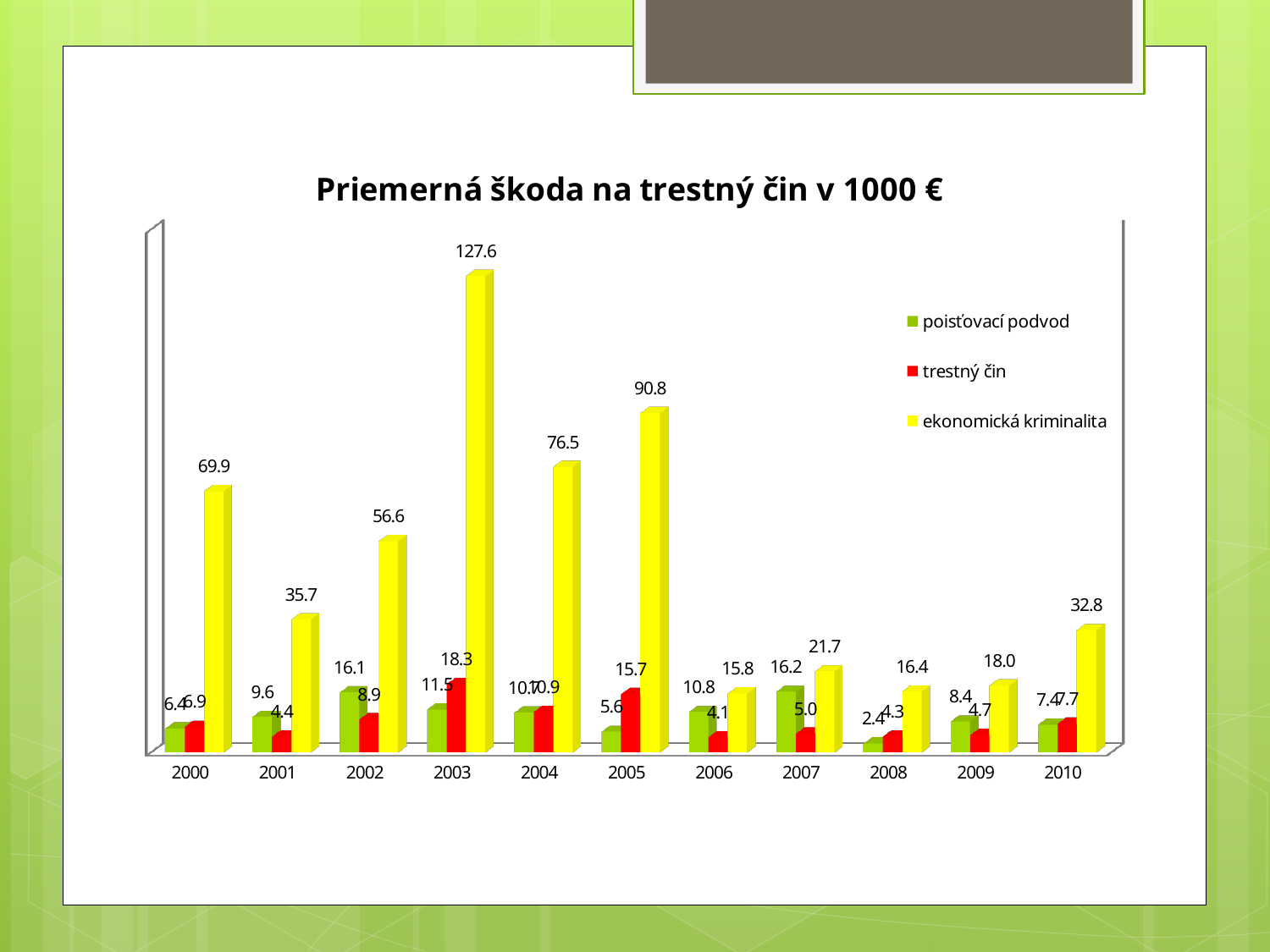
In which year is the value for poisťovací podvod lowest? 2008 How many series does the legend list? 3 What is the title of the chart? Priemerná škoda na trestný čin v 1000 € What is the difference between the ekonomická kriminalita values in 2003 and 2005? 36.8 What is the value for ekonomická kriminalita in 2010? 32.8 What is the value for trestný čin in 2005? 15.7 What is the value for poisťovací podvod in 2007? 16.2 How many years are shown on the x axis? 11 In which year is the value for ekonomická kriminalita highest? 2003 What is the value for ekonomická kriminalita in 2003? 127.6 Which is larger in 2002: poisťovací podvod or trestný čin? poisťovací podvod What kind of chart is shown on the slide? bar chart